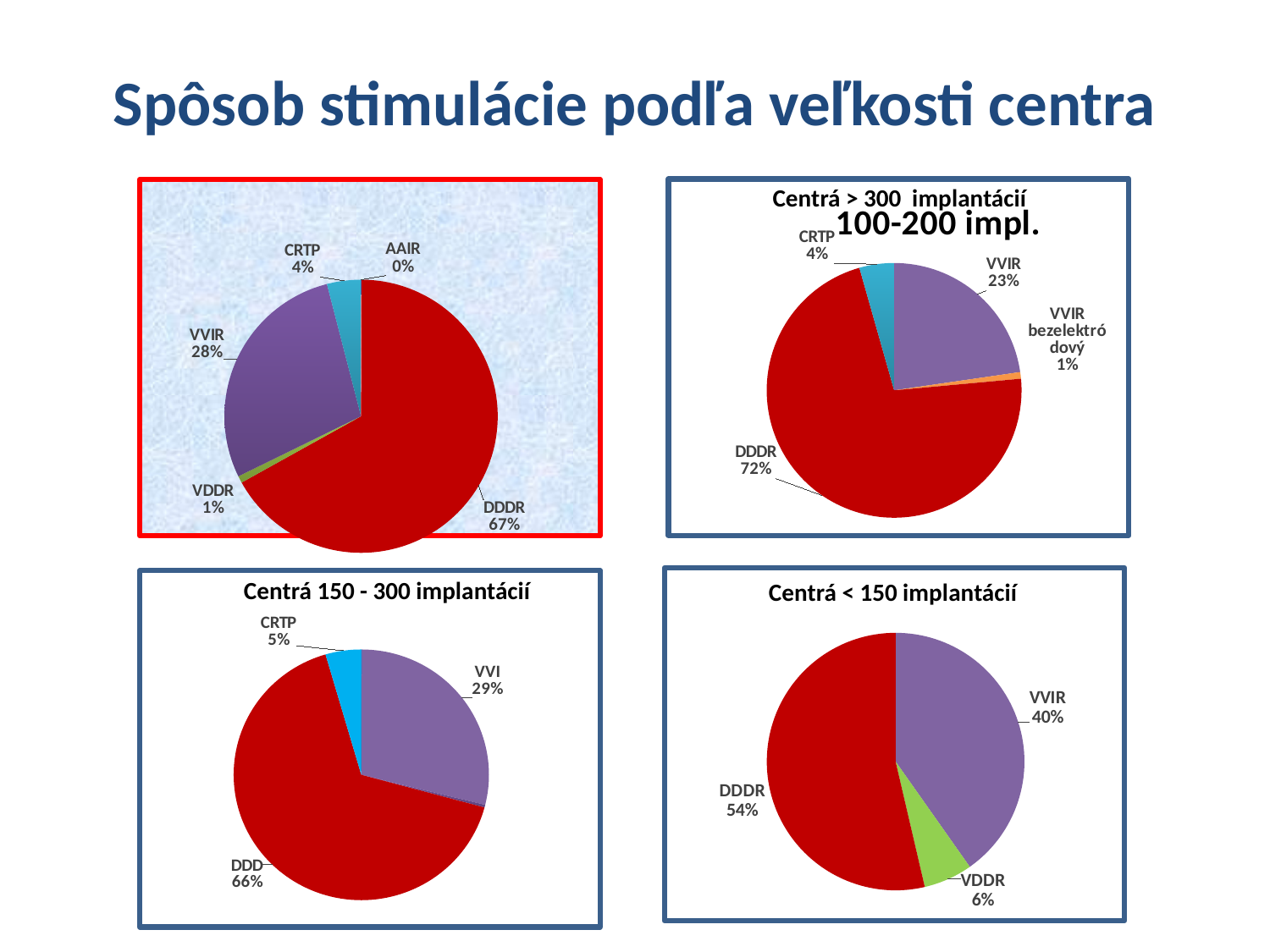
In the chart titled 'Centrá 150 - 300 implantácií', which category has the smallest share? CRTP In the top-right pie chart, what is the difference between the DDDR share and the VVIR share? 49% In the top-right pie chart, what share does VVIR bezelektródový have? 1% In the chart titled 'Centrá < 150 implantácií', which is larger, DDDR or VVIR? DDDR What type of chart is used in the chart titled 'Centrá < 150 implantácií'? Pie chart In the top-left pie chart, what share does DDDR have? 67% In the chart titled 'Centrá 150 - 300 implantácií', what share does VVI have? 29% In the top-right pie chart, what share does DDDR have? 72% In the top-left pie chart, how many categories are labelled? 5 In the top-left pie chart, what share does VVIR have? 28% In the top-left pie chart, which category has the largest share? DDDR In the chart titled 'Centrá < 150 implantácií', what share does VDDR have? 6%